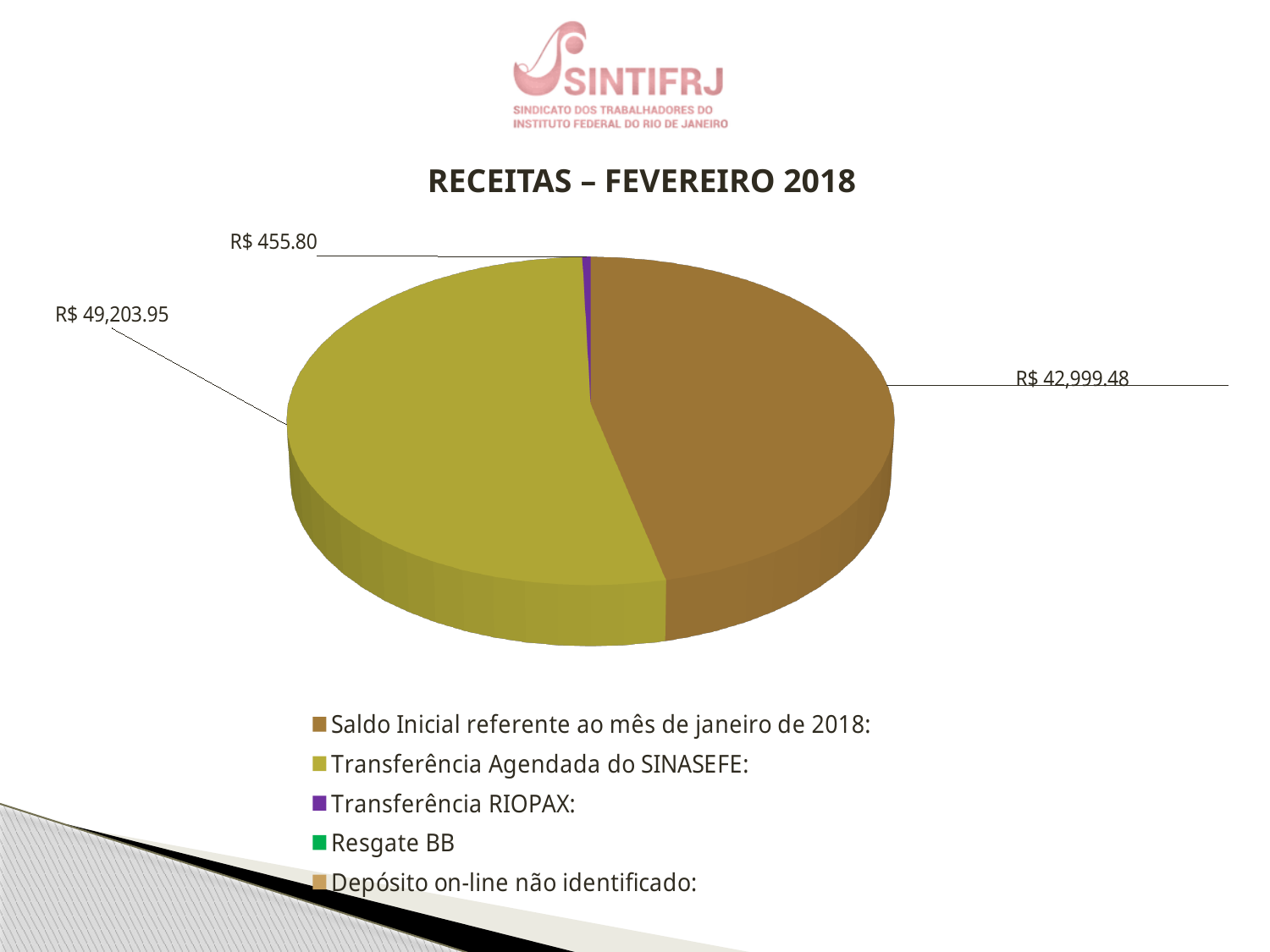
What colour is the slice for Transferência RIOPAX? Purple What type of chart is shown on the slide? Pie chart How many slices have a data label printed on the chart? 3 What is the difference between the value for Transferência Agendada do SINASEFE and the value for Saldo Inicial referente ao mês de janeiro de 2018? R$ 6,204.47 What is the value for Transferência Agendada do SINASEFE? R$ 49,203.95 What is the value for Transferência RIOPAX? R$ 455.80 Which is larger: Transferência Agendada do SINASEFE or Saldo Inicial referente ao mês de janeiro de 2018? Transferência Agendada do SINASEFE What is the title of the chart? RECEITAS – FEVEREIRO 2018 Which category has the largest slice of the pie? Transferência Agendada do SINASEFE How many entries does the legend list? 5 What is the value for Saldo Inicial referente ao mês de janeiro de 2018? R$ 42,999.48 Which of the labelled slices has the smallest value? Transferência RIOPAX